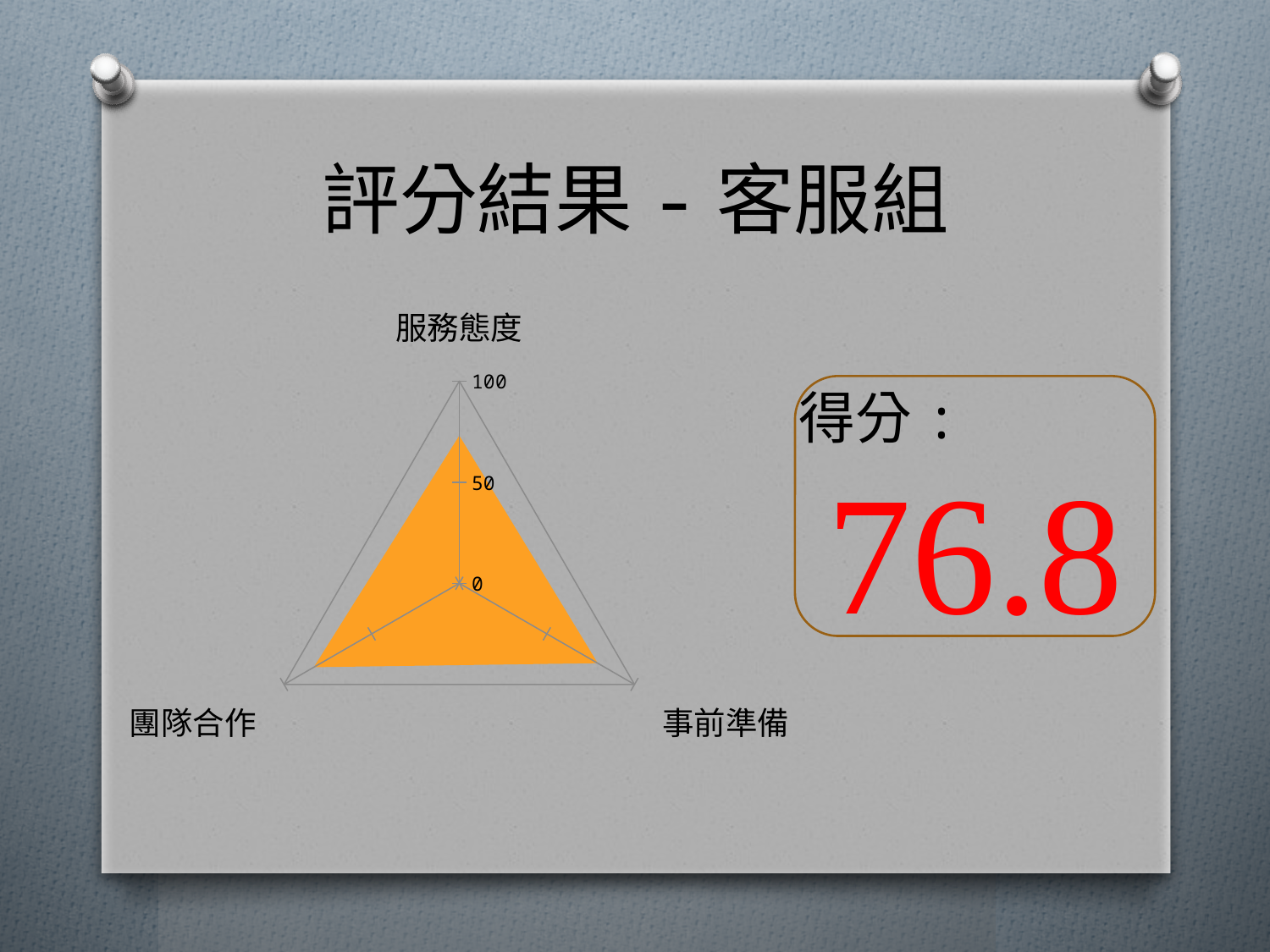
Is the value for 事前準備 greater or less than 100? less Which category has the lowest value in the radar chart? 服務態度 Which is larger, the value for 團隊合作 or the value for 服務態度? 團隊合作 What is the maximum value shown on the radar chart's axis scale? 100 What kind of chart is shown on the slide? radar chart Which is larger, the value for 事前準備 or the value for 服務態度? 事前準備 Is the value for 團隊合作 greater or less than 50? greater What colour is the filled area of the radar chart? orange Is the value for 服務態度 greater or less than 50? greater How many categories (axes) does the radar chart have? 3